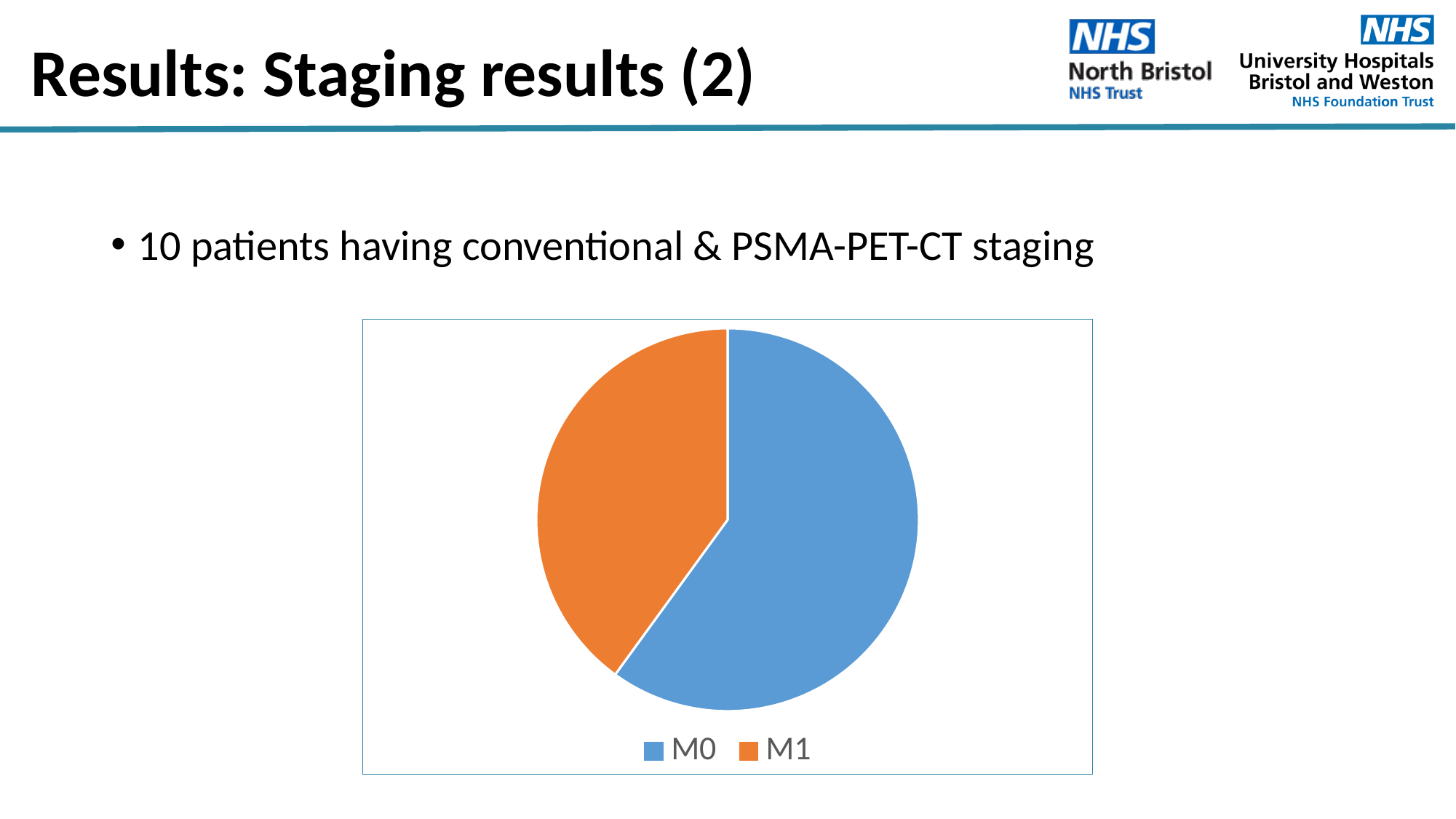
How many entries does the legend of the pie chart list? 2 What colour is the M1 slice in the pie chart? orange What colour is the M0 slice in the pie chart? blue Which category has the largest slice in the pie chart? M0 Which slice is larger in the pie chart, M0 or M1? M0 How many slices does the pie chart have? 2 What kind of chart is shown on the slide? pie chart Which category has the smallest slice in the pie chart? M1